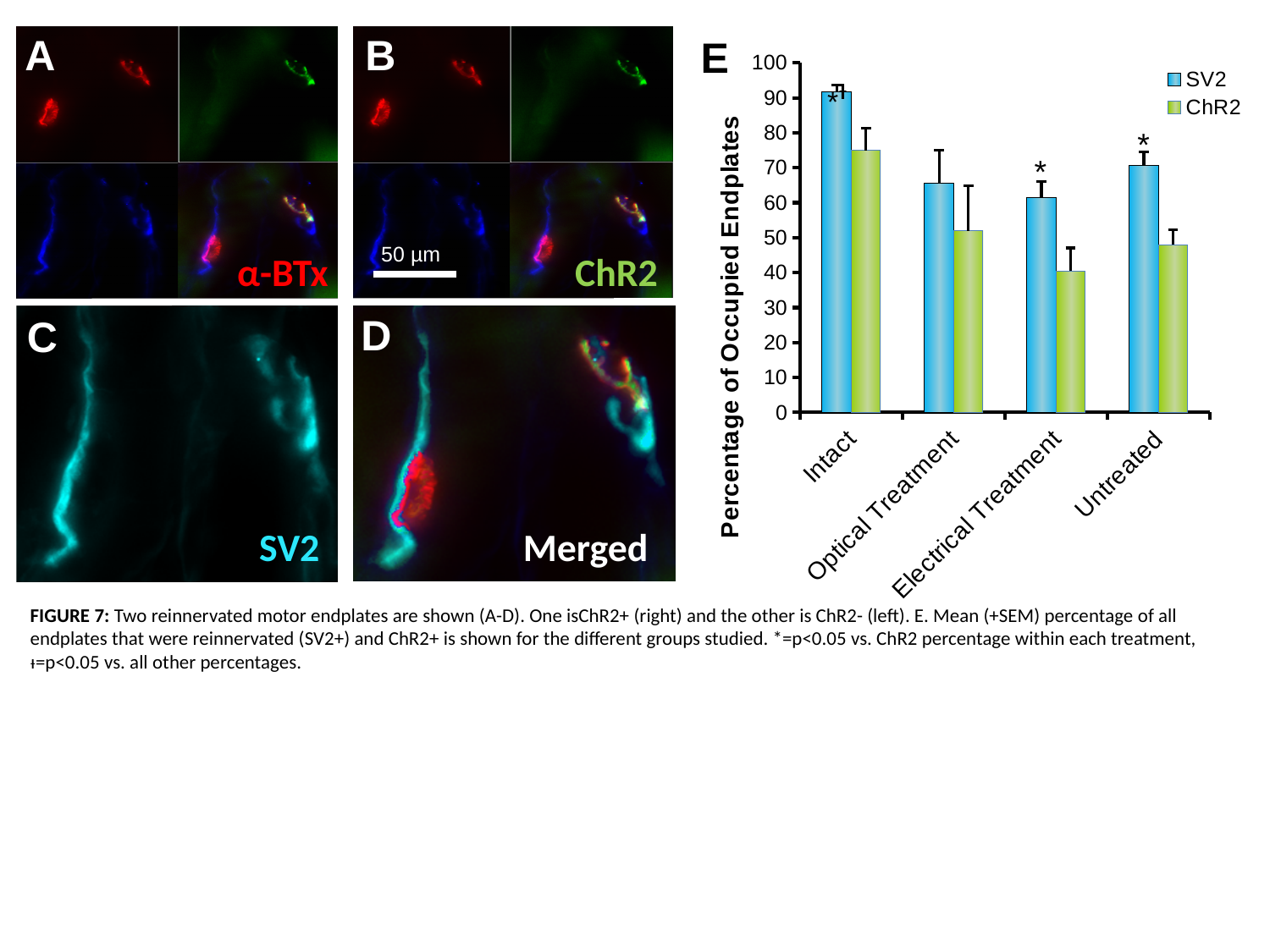
What is the y-axis title of the chart in panel E? Percentage of Occupied Endplates How many series does the legend of the chart in panel E list? 2 In the chart in panel E, which group has the lowest ChR2 value? Electrical Treatment In the chart in panel E, is the SV2 value for Untreated greater or less than 60? greater In the chart in panel E, is the ChR2 value for Electrical Treatment greater or less than 50? less How many treatment groups are shown on the x axis of the chart in panel E? 4 In the chart in panel E, is the SV2 value for Intact greater or less than 90? greater In the chart in panel E, which is larger for the Optical Treatment group, the SV2 value or the ChR2 value? SV2 In the chart in panel E, which group has the highest SV2 value? Intact What kind of chart is panel E? bar chart In the chart in panel E, which is larger, the ChR2 value for Intact or the ChR2 value for Untreated? Intact In the chart in panel E, which group has the lowest SV2 value? Electrical Treatment